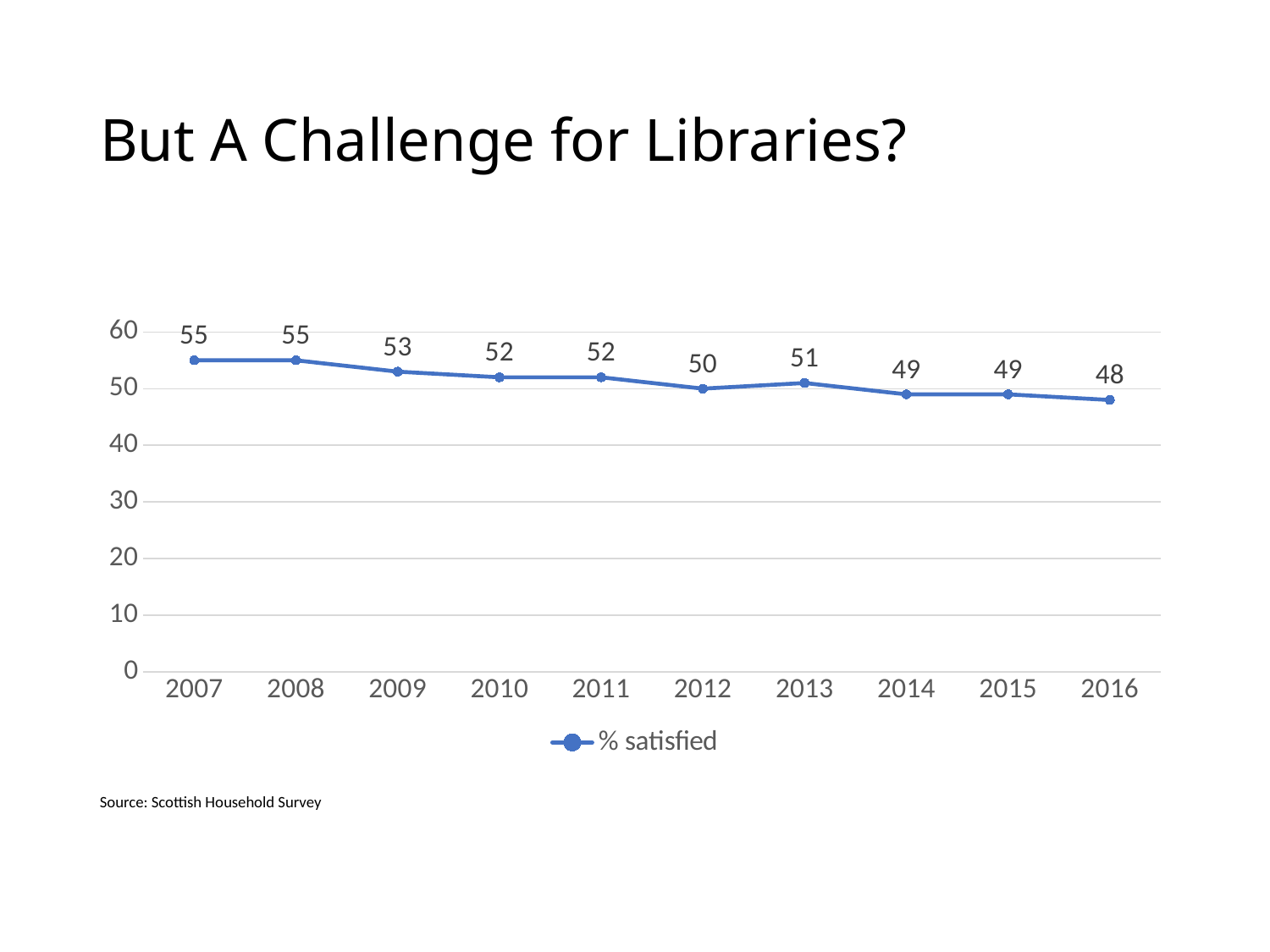
Is the % satisfied value for 2014 greater or less than 50? less What is the difference between the % satisfied values for 2007 and 2016? 7 How many years are plotted on the x axis? 10 What is the % satisfied value for 2007? 55 Which year has the larger % satisfied value, 2009 or 2013? 2009 Do the % satisfied values generally rise or fall from 2007 to 2016? fall What is the % satisfied value for 2016? 48 Which year has the lowest % satisfied value? 2016 What is the name of the series shown in the legend? % satisfied What is the % satisfied value for 2012? 50 How many series does the legend list? 1 What kind of chart is shown on the slide? line chart